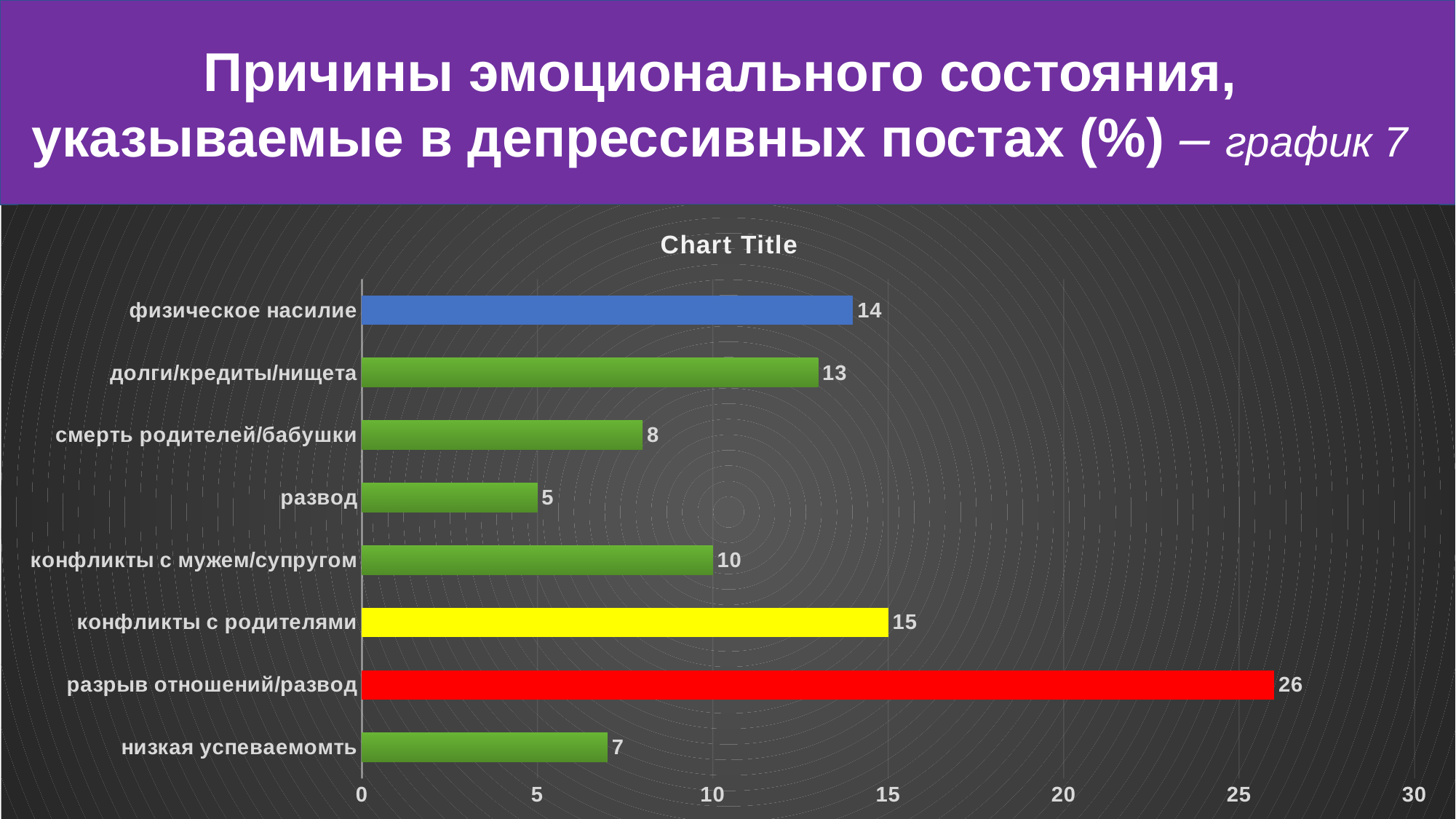
Which category has the highest value? разрыв отношений/развод What kind of chart is shown on the slide? bar chart What is the value for конфликты с мужем/супругом? 10 Which is larger, the value for долги/кредиты/нищета or the value for смерть родителей/бабушки? долги/кредиты/нищета What is the title printed above the chart? Chart Title How many categories are shown in the chart? 8 Is the value for низкая успеваемомть greater or less than 10? less What is the difference between the values for разрыв отношений/развод and конфликты с родителями? 11 What colour is the bar for конфликты с родителями? yellow What is the value for физическое насилие? 14 Which category has the lowest value? развод What is the value for разрыв отношений/развод? 26